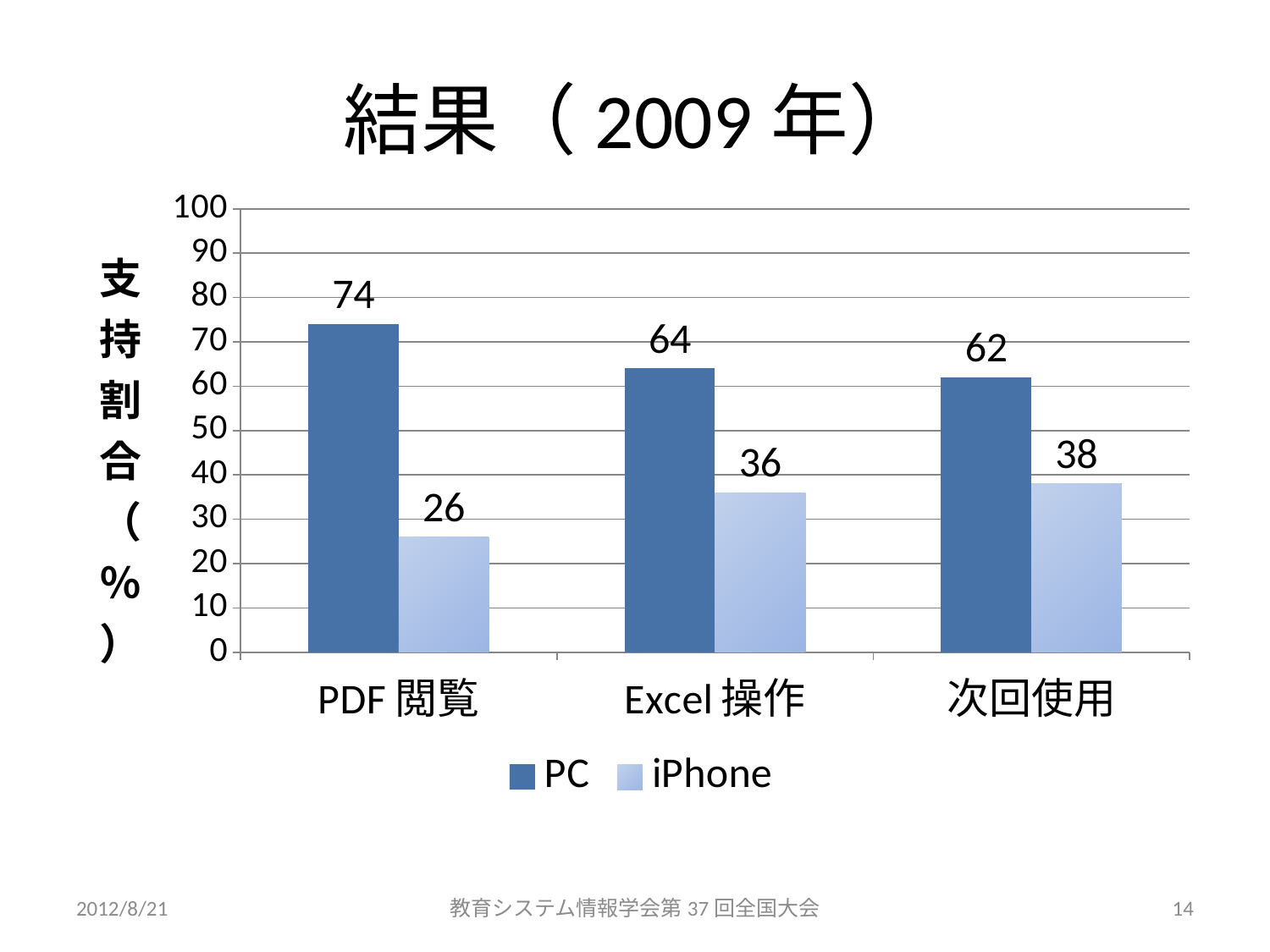
What is the title of the slide? 結果（2009年） What is the iPhone value for 次回使用? 38 What kind of chart is shown on the slide? bar chart How many categories are shown on the x axis? 3 Which category has the lowest iPhone value? PDF 閲覧 What is the iPhone value for Excel 操作? 36 What is the difference between the PC values for Excel 操作 and 次回使用? 2 How many series does the legend list? 2 What is the PC value for PDF 閲覧? 74 What is the difference between the PC and iPhone values for PDF 閲覧? 48 Which is larger for 次回使用, the PC value or the iPhone value? PC Which category has the highest PC value? PDF 閲覧